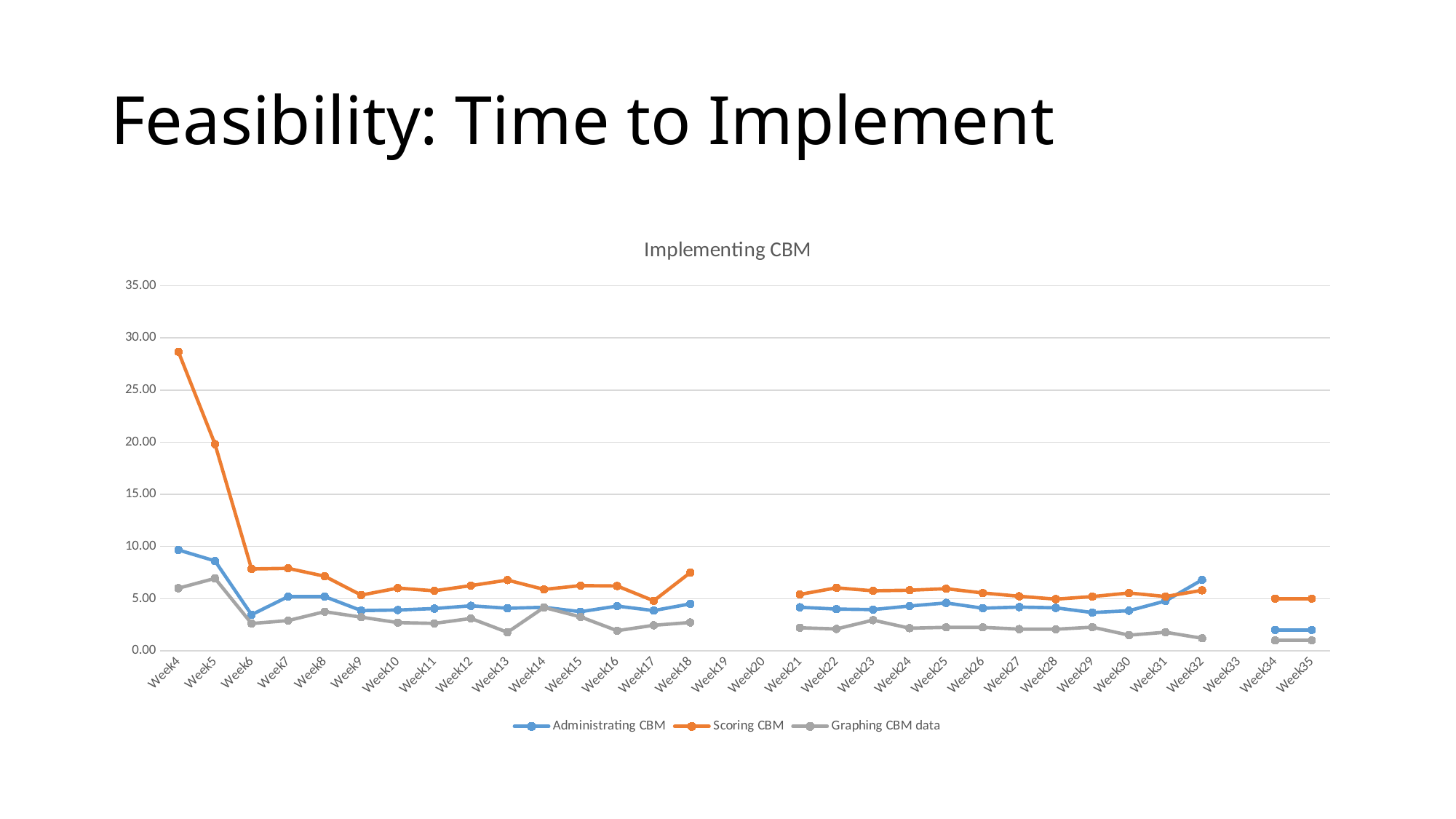
At which week does Scoring CBM reach its highest value? Week4 Is the value for Scoring CBM at Week4 greater or less than 25.00? greater Which series has the highest value at Week4? Scoring CBM Which series is drawn in orange? Scoring CBM Is the value for Graphing CBM data at Week6 greater or less than 5.00? less What is the title of the chart? Implementing CBM Is the value for Scoring CBM at Week5 greater or less than 15.00? greater How many series does the legend list? 3 How many week categories are labelled on the x axis? 32 What kind of chart is shown on the slide? line chart At Week35, which is larger: Administrating CBM or Graphing CBM data? Administrating CBM Does the Scoring CBM line rise or fall from Week4 to Week6? fall